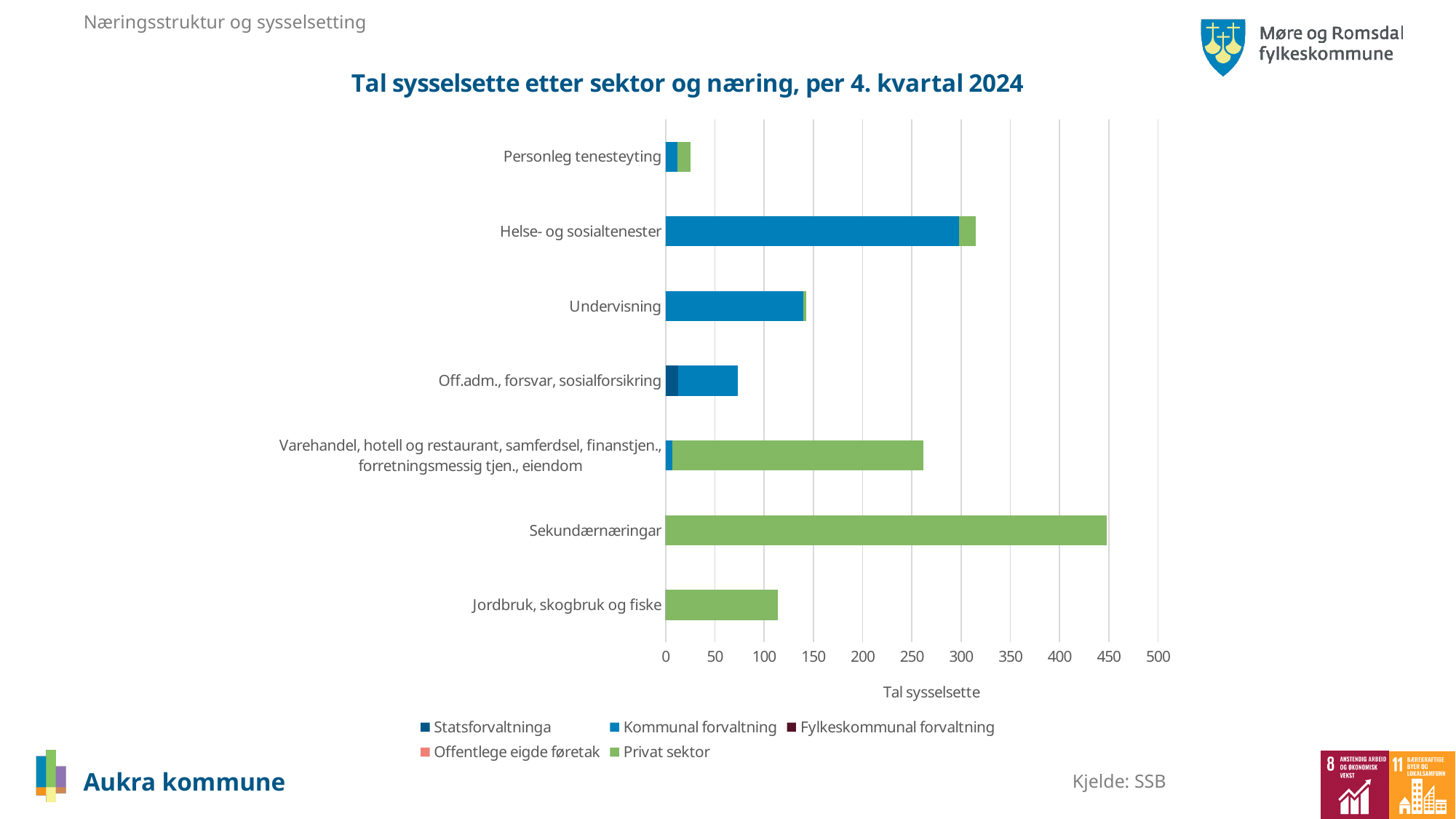
Which category has the shortest bar in the chart? Personleg tenesteyting Is the total value for Helse- og sosialtenester greater or less than 300? greater How many series does the legend list? 5 What is the title of the chart? Tal sysselsette etter sektor og næring, per 4. kvartal 2024 What kind of chart is shown on the slide? bar chart Which category has the longest bar in the chart? Sekundærnæringar How many categories (næringar) are shown on the y axis of the chart? 7 Is the total value for Jordbruk, skogbruk og fiske greater or less than 100? greater Is the total value for Sekundærnæringar greater or less than 400? greater Which has the larger total: Helse- og sosialtenester or Varehandel, hotell og restaurant, samferdsel, finanstjen., forretningsmessig tjen., eiendom? Helse- og sosialtenester What is the label of the x axis? Tal sysselsette